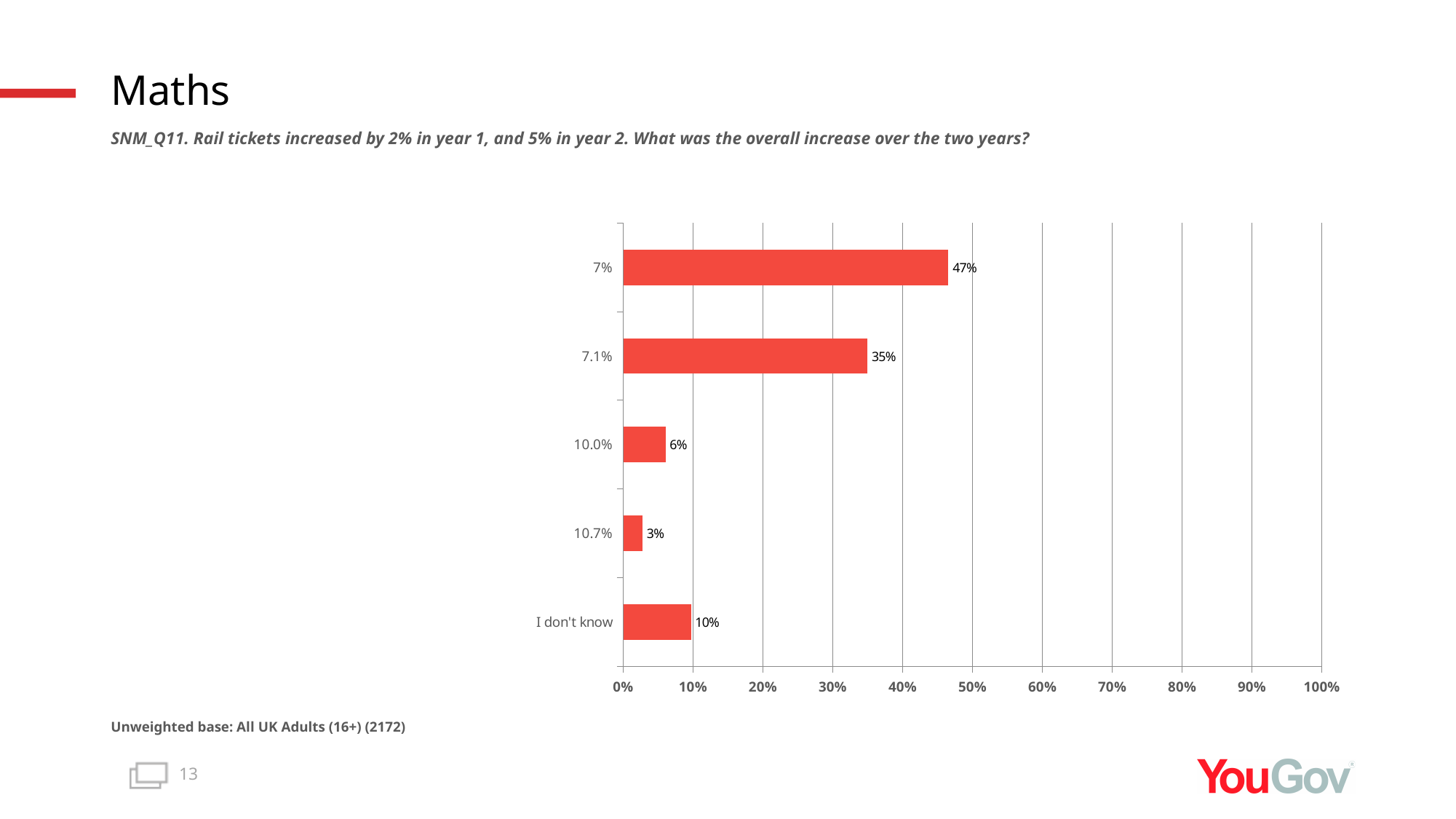
What percentage of respondents answered "7.1%"? 35% What percentage of respondents answered "7%"? 47% What kind of chart is shown on the slide? Bar chart Which received a larger share of respondents, "10.0%" or "I don't know"? I don't know What is the difference in percentage points between the "7%" and "7.1%" answers? 12 How many answer options are shown on the chart? 5 Which answer option has the lowest share of respondents? 10.7% Which answer option has the highest share of respondents? 7% What percentage of respondents answered "10.0%"? 6% Is the value for the "7%" answer greater or less than 40%? greater What is the unweighted base stated on the slide? All UK Adults (16+) (2172) What percentage of respondents answered "I don't know"? 10%